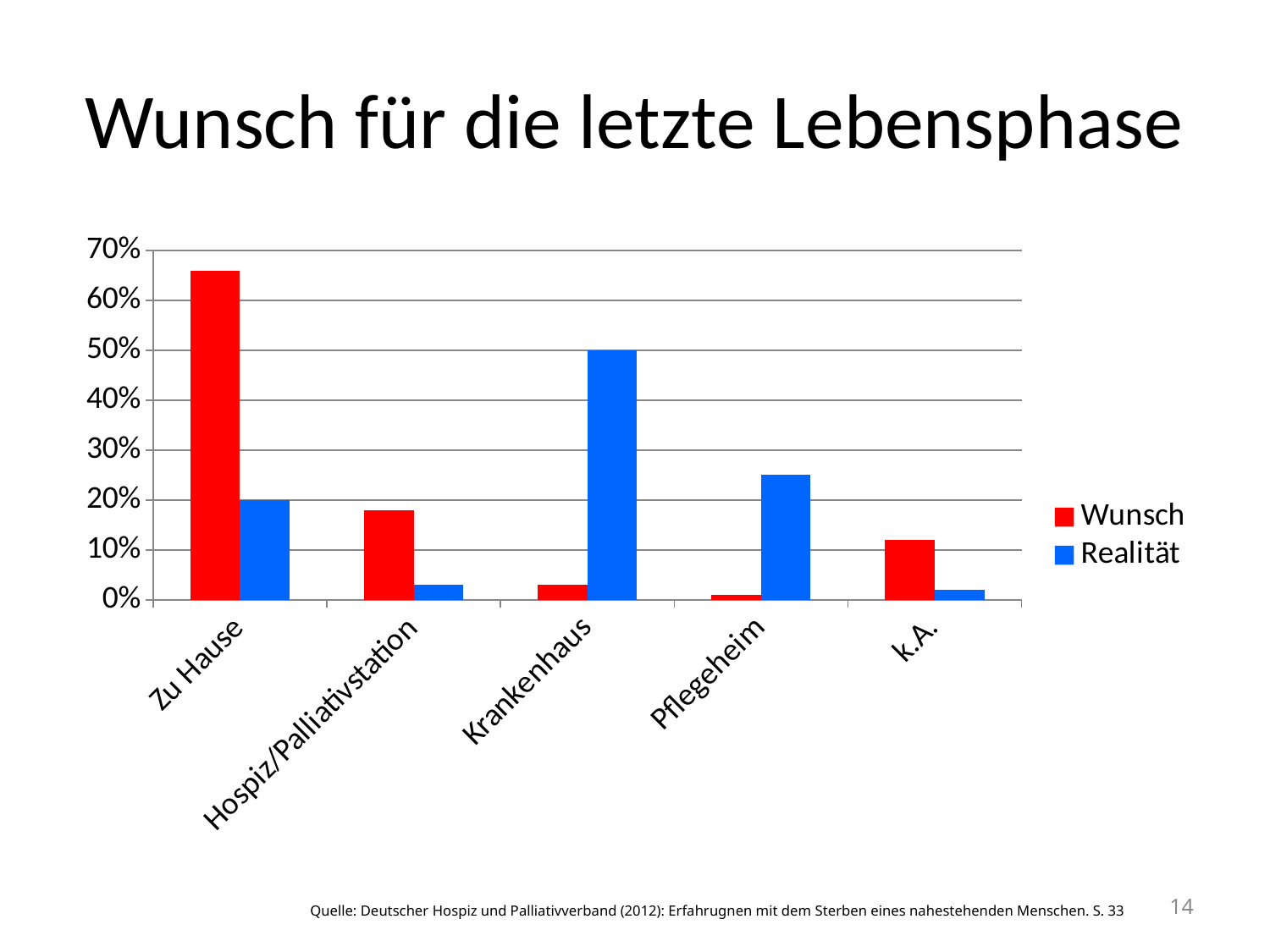
Which colour represents the Realität series in the legend? blue Is the Realität value for Pflegeheim greater or less than 20%? greater What is the Realität value for Zu Hause? 20% For Hospiz/Palliativstation, which is larger, the Wunsch value or the Realität value? Wunsch Which category has the highest Realität value? Krankenhaus Is the Wunsch value for Zu Hause greater or less than 60%? greater How many categories are shown on the x axis? 5 What type of chart is shown on the slide? bar chart What is the Realität value for Krankenhaus? 50% How many series does the legend list? 2 Which category has the highest Wunsch value? Zu Hause Which category has the lowest Wunsch value? Pflegeheim